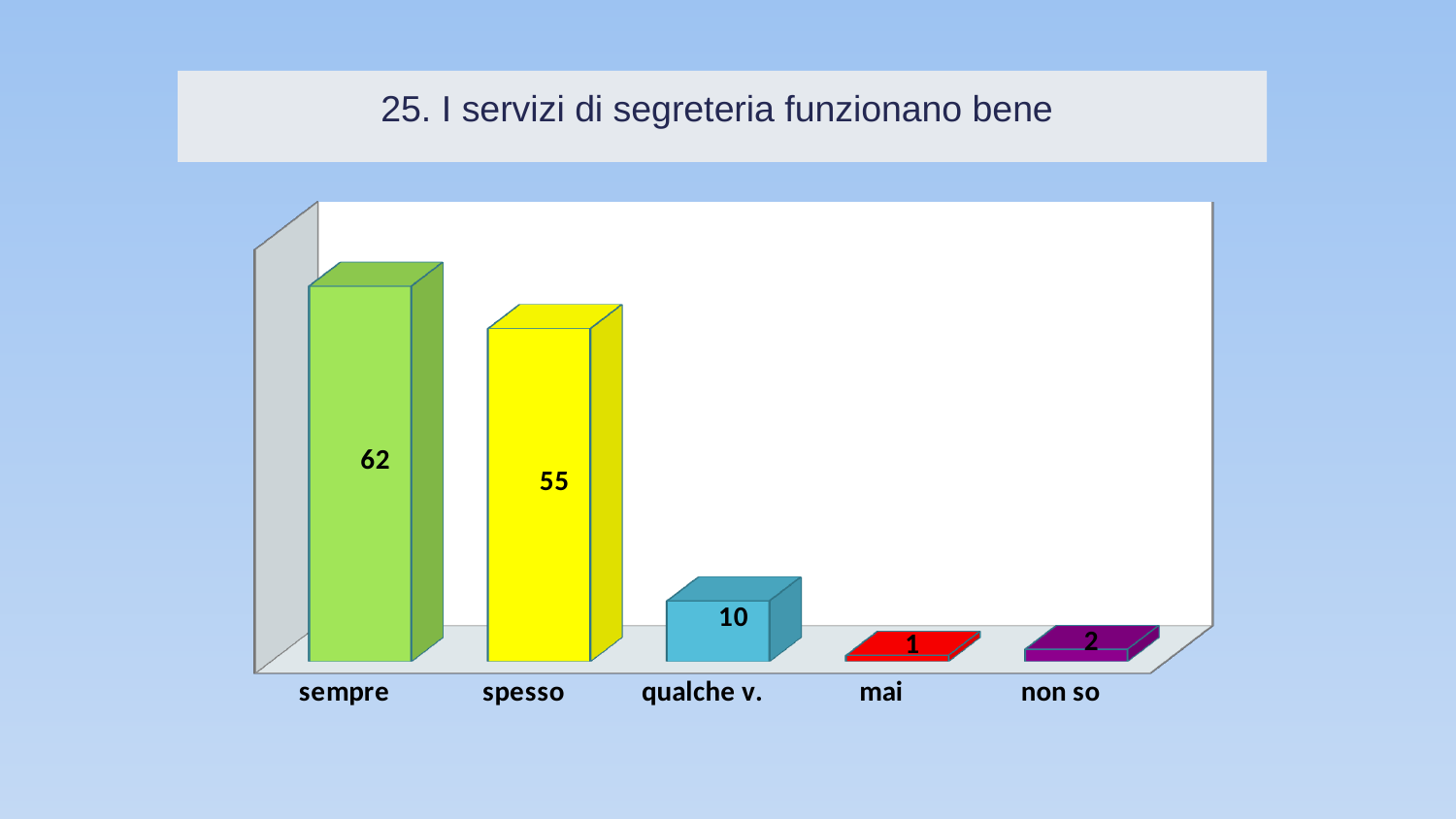
Which category has the highest value? sempre What is the value for "spesso"? 55 How many categories are shown on the x axis? 5 What is the title of the chart? 25. I servizi di segreteria funzionano bene Which category has the lowest value? mai Which is larger, the value for "spesso" or the value for "qualche v."? spesso What is the value for "non so"? 2 What is the value for "qualche v."? 10 What is the value for "sempre"? 62 What is the value for "mai"? 1 What is the difference between the values for "sempre" and "spesso"? 7 What kind of chart is shown on the slide? bar chart